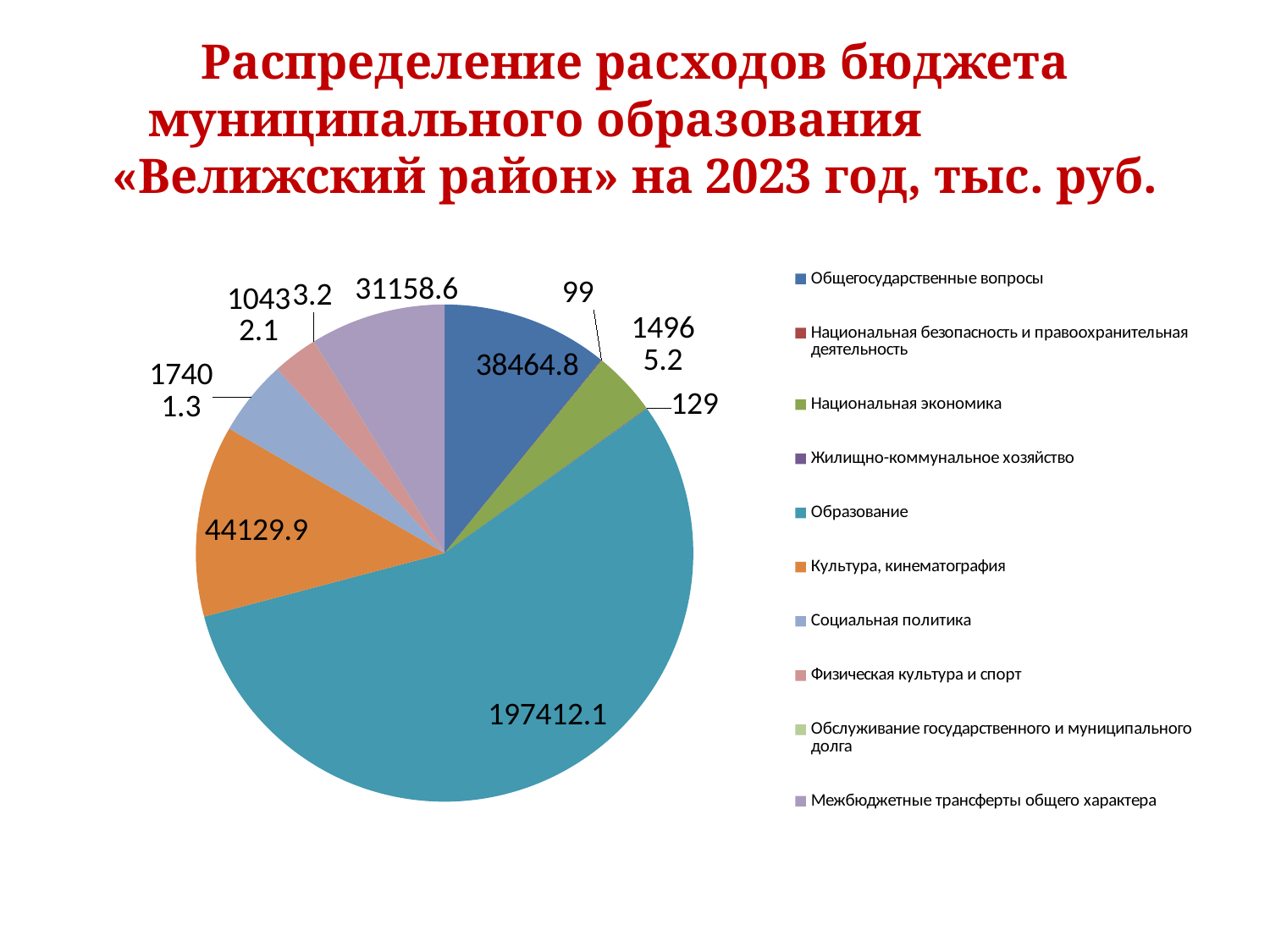
Which category has the largest slice of the pie? Образование What is the value for Образование in the pie chart? 197412.1 What is the value for Общегосударственные вопросы? 38464.8 What is the difference between the values for Образование and Культура, кинематография? 153282.2 What kind of chart is shown on the slide? pie chart Which is larger: Культура, кинематография or Общегосударственные вопросы? Культура, кинематография What is the value for Жилищно-коммунальное хозяйство? 129 What is the value for Межбюджетные трансферты общего характера? 31158.6 How many categories does the legend of the pie chart list? 10 What is the value for Культура, кинематография? 44129.9 What is the difference between the values for Культура, кинематография and Общегосударственные вопросы? 5665.1 In what units are the values in the chart expressed, according to the slide title? тыс. руб.